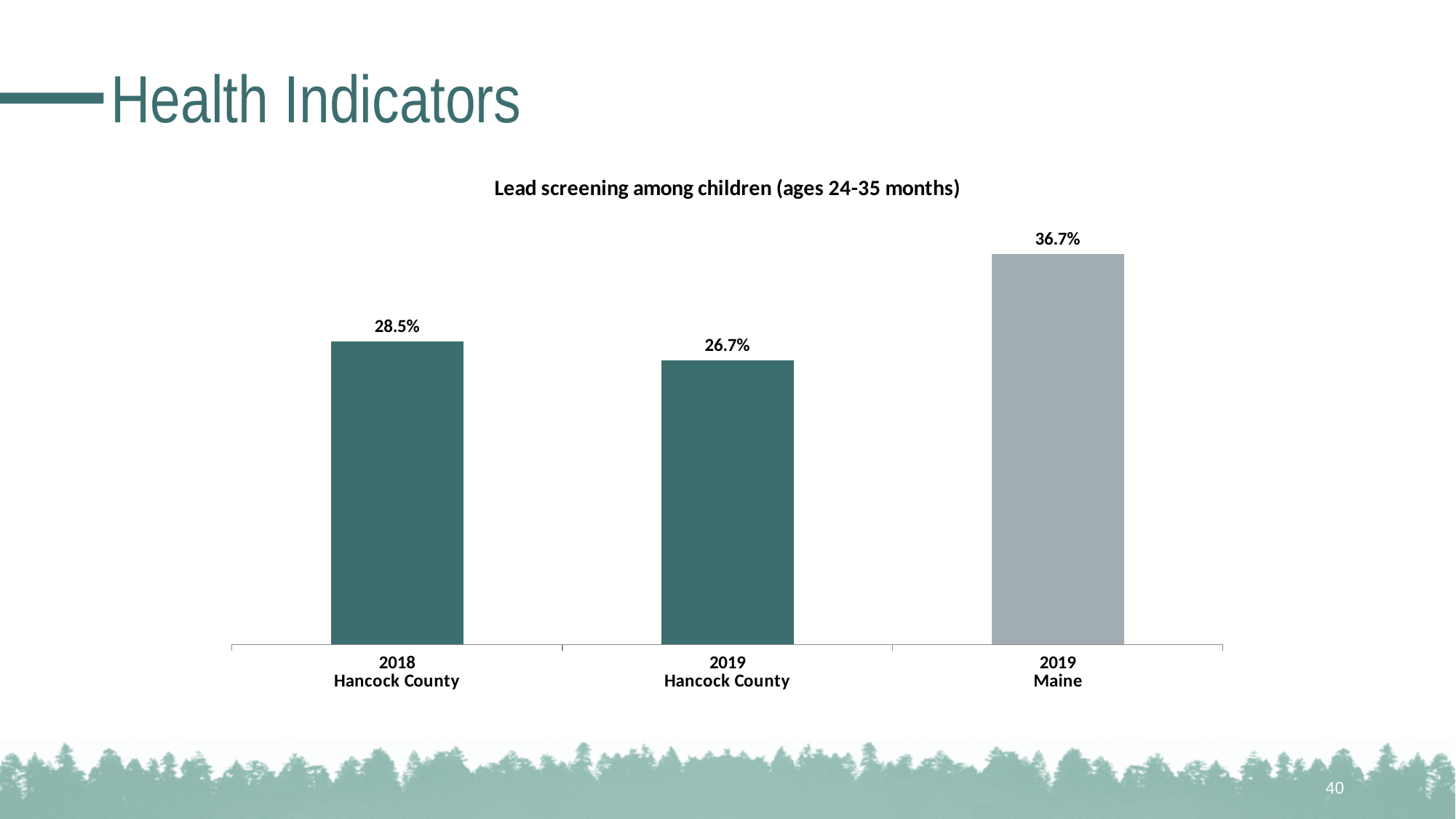
What type of chart is shown on the slide? Bar chart By how much did the Hancock County rate change from 2018 to 2019? Decreased by 1.8 percentage points Which bar has the lowest value? 2019 Hancock County What is the lead screening rate for Hancock County in 2018? 28.5% What is the lead screening rate for Maine in 2019? 36.7% Which bar is shown in a different (grey) colour from the others? 2019 Maine What is the lead screening rate for Hancock County in 2019? 26.7% How many bars are shown in the chart? 3 What is the title of the chart? Lead screening among children (ages 24-35 months) Which is larger, the 2018 Hancock County rate or the 2019 Hancock County rate? 2018 Hancock County What is the difference between the 2019 Maine rate and the 2019 Hancock County rate? 10 percentage points Which bar has the highest value? 2019 Maine